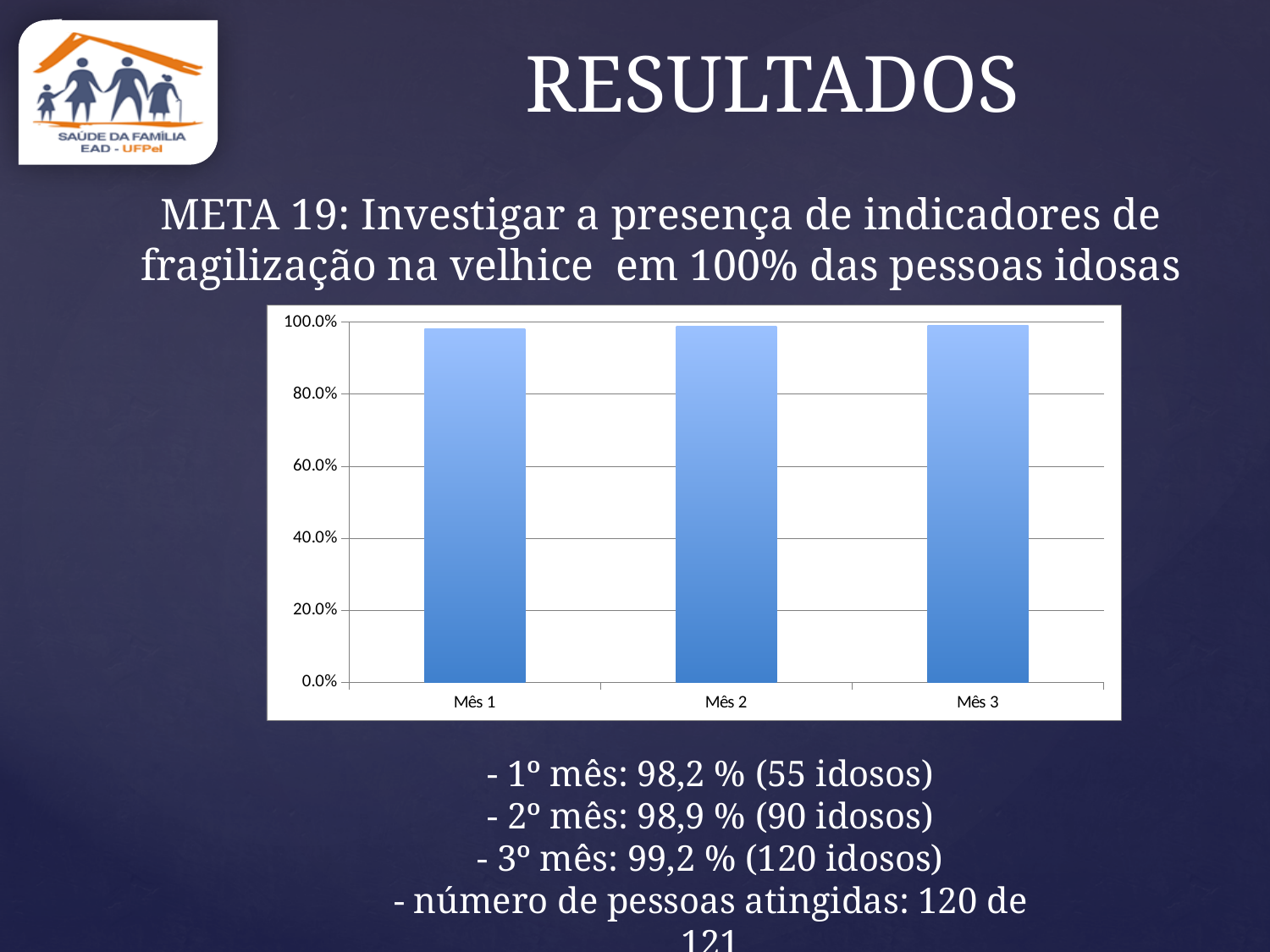
What is the label of the first category on the x axis? Mês 1 What is the value for Mês 2 according to the slide? 98,9 % Do the values rise or fall from Mês 1 to Mês 3? rise What is the difference between the values for Mês 3 and Mês 1? 1,0 % What is the highest tick value shown on the vertical axis? 100.0% Which month has the lowest value? Mês 1 How many categories (months) are plotted on the chart? 3 What is the value for Mês 3 according to the slide? 99,2 % Which month has the highest value? Mês 3 What kind of chart is shown on the slide? bar chart Is the value for Mês 2 greater or less than 80.0%? greater What is the value for Mês 1 according to the slide? 98,2 %